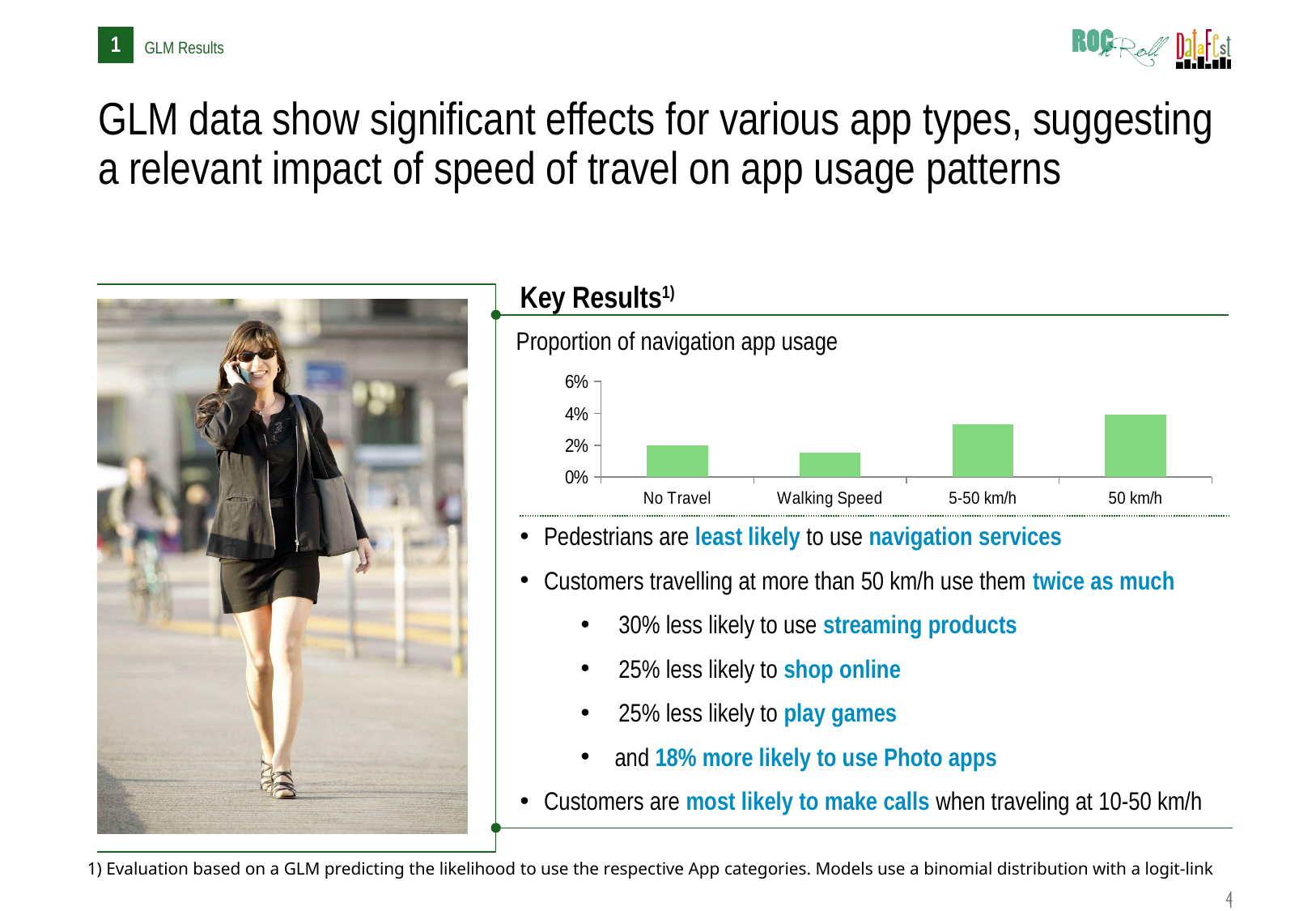
Is the value for 5-50 km/h greater or less than 2%? greater Which category has the highest proportion of navigation app usage? 50 km/h Is the value for Walking Speed greater or less than 2%? less Which category has the lowest proportion of navigation app usage? Walking Speed Is the value for 5-50 km/h greater or less than 4%? less Which is larger, the value for 5-50 km/h or the value for No Travel? 5-50 km/h Which is larger, the value for 50 km/h or the value for Walking Speed? 50 km/h How many categories are shown on the x axis of the chart? 4 What is the title of the chart? Proportion of navigation app usage What kind of chart is shown on the slide? bar chart What is the highest value shown on the y axis of the chart? 6%